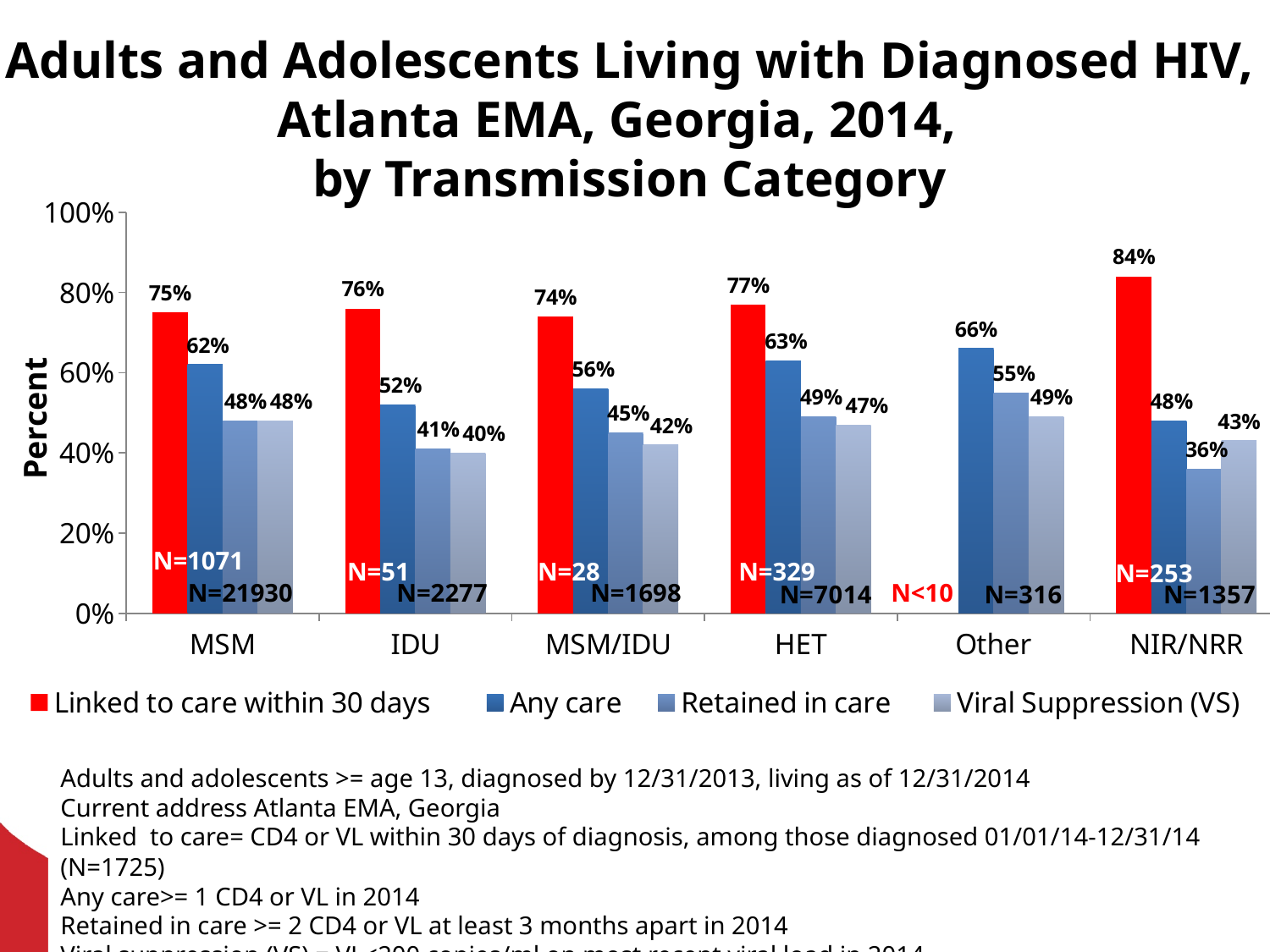
Which is larger, the Viral Suppression (VS) value for HET or for MSM/IDU? HET What is the Any care value for the HET category? 63% What is the difference between the Any care value for MSM and the Any care value for IDU? 10% What kind of chart is shown on the slide? Bar chart Which transmission category has the lowest Retained in care value? NIR/NRR Which transmission category has the highest Linked to care within 30 days value? NIR/NRR Which series is shown in red in the legend? Linked to care within 30 days What is the Viral Suppression (VS) value for the IDU category? 40% What is the Retained in care value for the Other category? 55% How many transmission categories are shown on the x axis? 6 What is the value for Linked to care within 30 days for the NIR/NRR category? 84% How many series does the legend list? 4